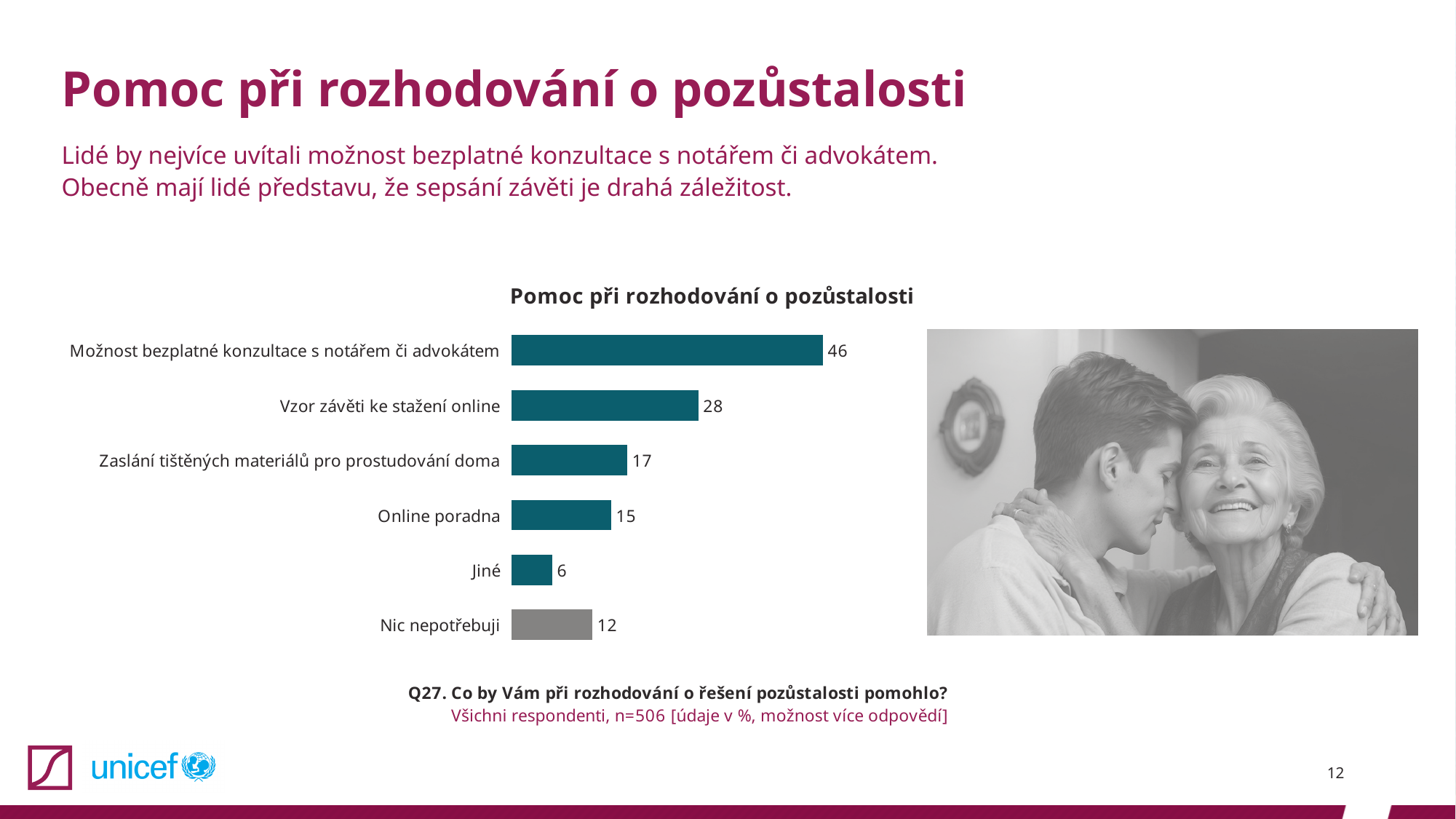
What is the value for "Online poradna"? 15 Which category has the lowest value? Jiné What is the value for "Možnost bezplatné konzultace s notářem či advokátem"? 46 What is the title of the chart? Pomoc při rozhodování o pozůstalosti What is the value for "Vzor závěti ke stažení online"? 28 Which is larger, the value for "Nic nepotřebuji" or the value for "Jiné"? Nic nepotřebuji What kind of chart is shown on the slide? Bar chart What is the value for "Nic nepotřebuji"? 12 What is the difference between the values for "Možnost bezplatné konzultace s notářem či advokátem" and "Vzor závěti ke stažení online"? 18 How many categories are shown in the chart? 6 What is the difference between the values for "Zaslání tištěných materiálů pro prostudování doma" and "Online poradna"? 2 Which category has the highest value? Možnost bezplatné konzultace s notářem či advokátem